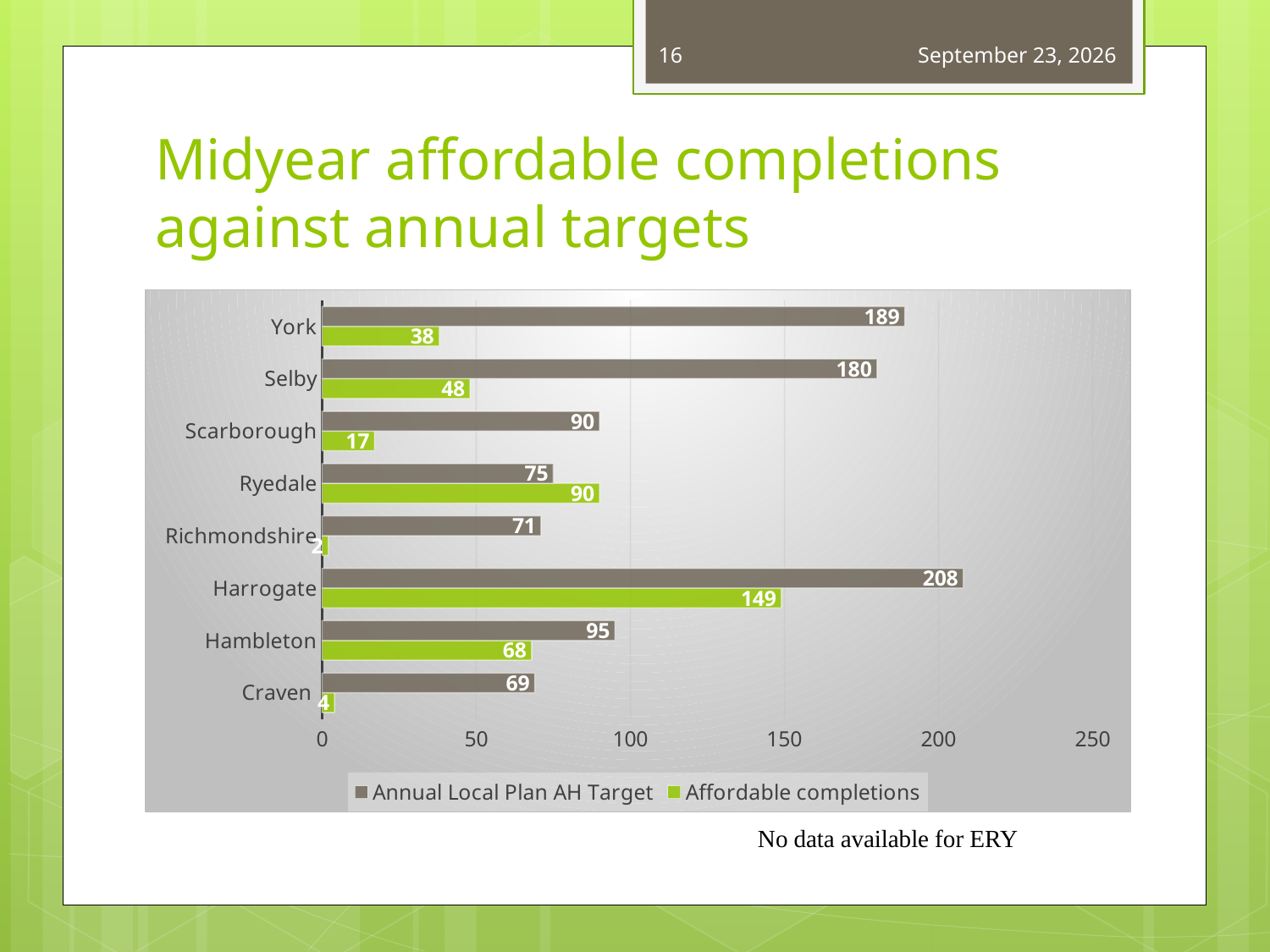
Is the Annual Local Plan AH Target for Selby greater or less than 150? greater How many affordable completions are shown for Selby? 48 What is the difference between the Annual Local Plan AH Target and Affordable completions for York? 151 What kind of chart is shown on the slide? Bar chart What is the Affordable completions value for Ryedale? 90 Which category has the highest Annual Local Plan AH Target? Harrogate What is the Annual Local Plan AH Target for Harrogate? 208 Which is larger for Ryedale: the Annual Local Plan AH Target or the Affordable completions? Affordable completions What is the title of the chart on the slide? Midyear affordable completions against annual targets How many series does the legend list? 2 Which category has the lowest Affordable completions value? Richmondshire How many categories (local authorities) are shown on the chart? 8